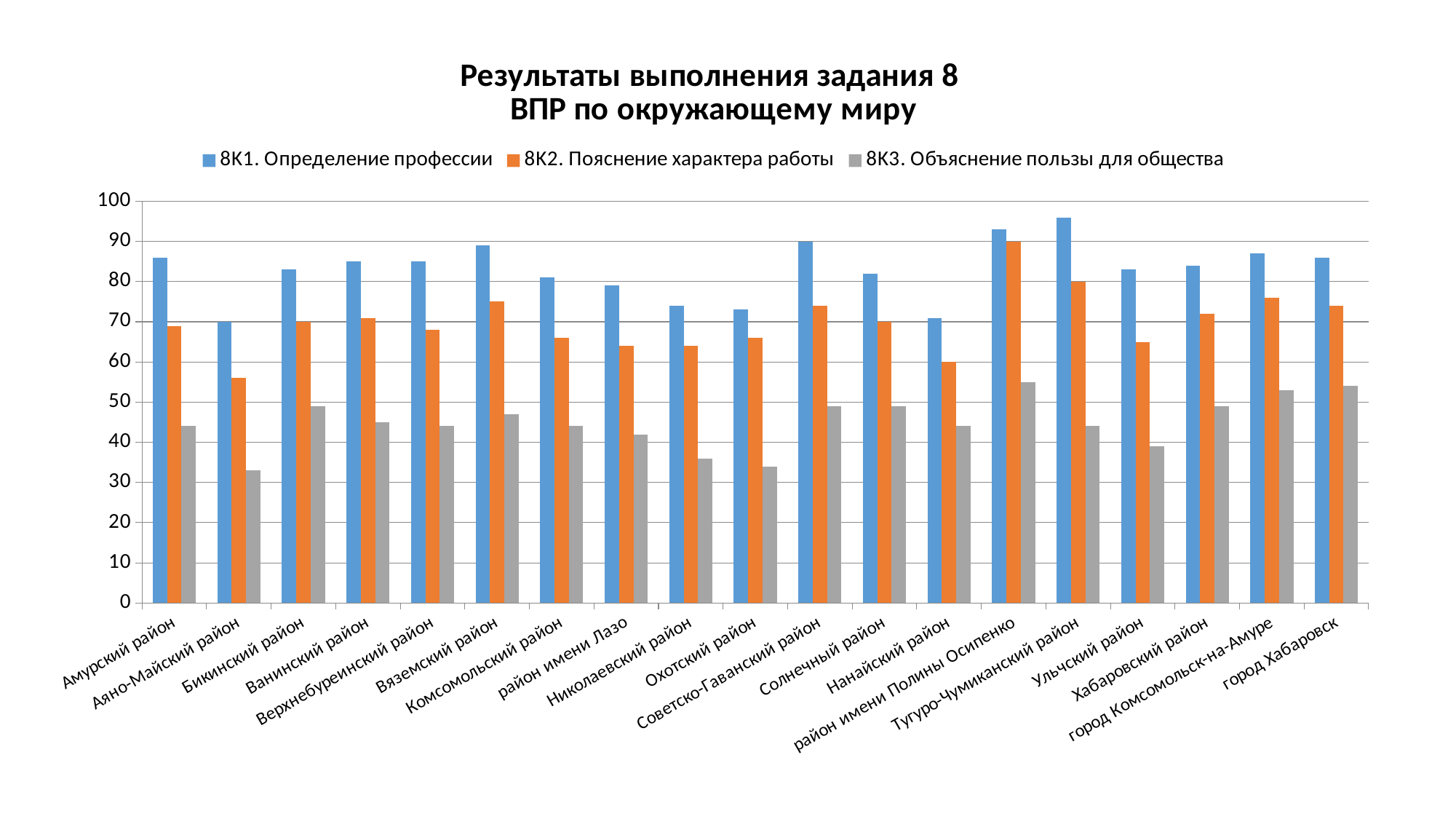
How many districts (categories) are shown on the x axis? 19 How many series does the legend list? 3 Is the value for 8К3. Объяснение пользы для общества in Николаевский район greater or less than 50? less Is the value for 8К1. Определение профессии in Тугуро-Чумиканский район greater or less than 90? greater Which district has the lowest value for the series 8К2. Пояснение характера работы? Аяно-Майский район Is the value for 8К3. Объяснение пользы для общества in Аяно-Майский район greater or less than 40? less For the series 8К2. Пояснение характера работы, which is larger: Тугуро-Чумиканский район or Ульчский район? Тугуро-Чумиканский район Which district has the highest value for the series 8К2. Пояснение характера работы? район имени Полины Осипенко What kind of chart is shown on the slide? bar chart Which colour represents the series 8К3. Объяснение пользы для общества in the legend? grey For the series 8К1. Определение профессии, which is larger: Вяземский район or Охотский район? Вяземский район